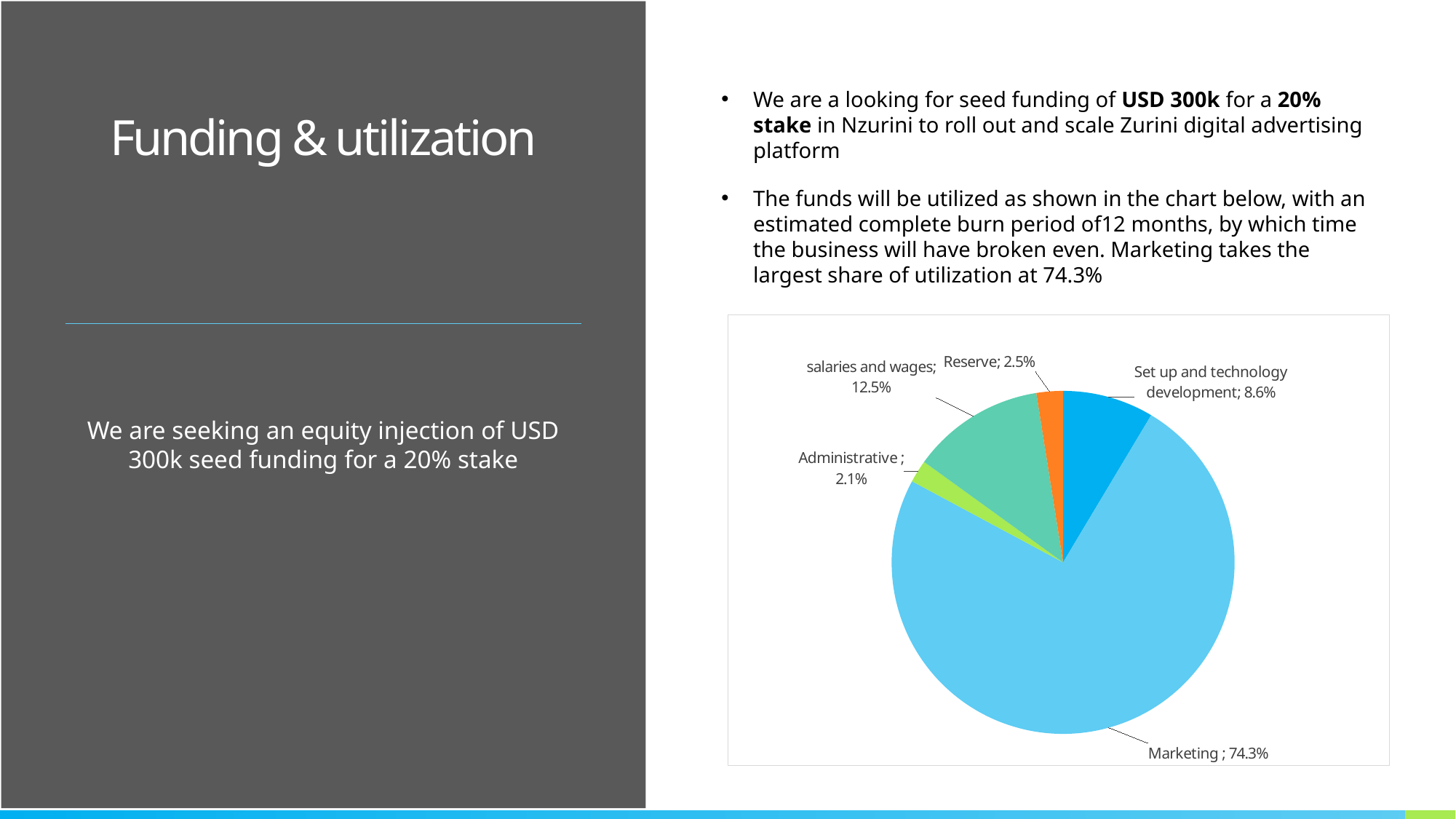
Which has a larger share, Set up and technology development or Reserve? Set up and technology development How many slices does the pie chart have? 5 What share of the funds is allocated to salaries and wages? 12.5% What colour is the Reserve slice? Orange What share of the funds is allocated to Marketing? 74.3% What share of the funds is allocated to Set up and technology development? 8.6% What share of the funds is allocated to Administrative? 2.1% Which category takes the largest share of the pie? Marketing What share of the funds is allocated to Reserve? 2.5% What kind of chart is shown on the slide? Pie chart Which category takes the smallest share of the pie? Administrative What is the difference in share between Marketing and salaries and wages? 61.8%